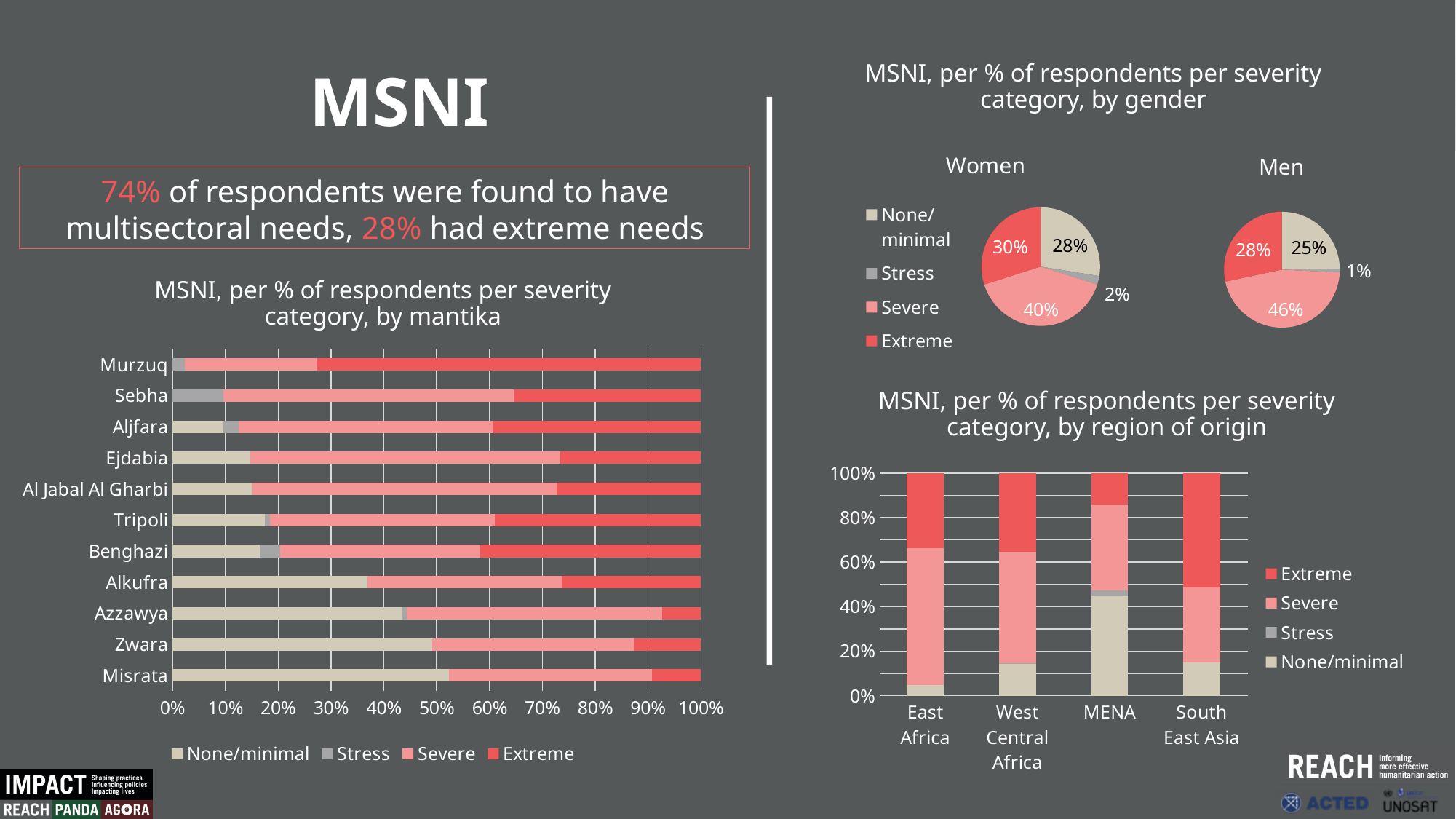
In the chart by region of origin, is the None/minimal share for MENA greater or less than 40%? greater In the Men pie chart, which severity category has the smallest share? Stress How many mantikas are listed in the chart 'MSNI, per % of respondents per severity category, by mantika'? 11 In the Women pie chart, which severity category has the largest share? Severe In the pie charts by gender, is the Extreme share larger for women or for men? Women How many series does the legend list in the chart 'MSNI, per % of respondents per severity category, by region of origin'? 4 In the pie charts by gender, how much larger is the Severe share for men than for women? 6% In the pie charts by gender, what percentage of women fall in the Severe category? 40% In the pie charts by gender, what percentage of men fall in the None/minimal category? 25% In the pie charts by gender, what percentage of men fall in the Stress category? 1% In the chart by mantika, is the Extreme share for Murzuq greater or less than 70%? greater What kind of chart is used for the MSNI by gender breakdown? Pie chart